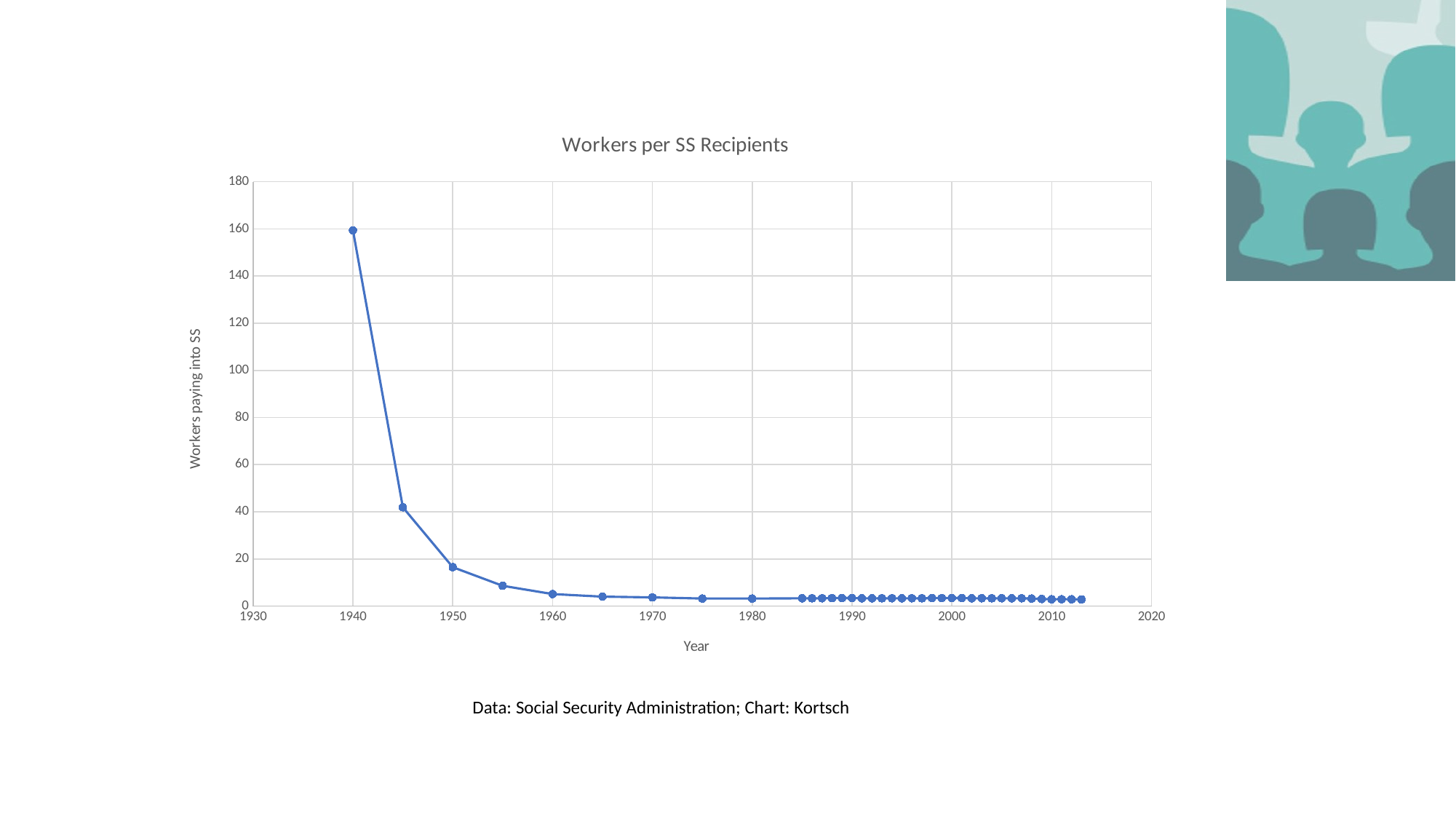
What kind of chart is shown on the slide? line chart What is the label on the vertical axis of the chart? Workers paying into SS Do the values rise or fall as the year increases along the x axis? fall Is the value for 1940 greater or less than 140? greater What is the title of the chart? Workers per SS Recipients Is the value for 1945 greater or less than 20? greater Which has the larger value, 1940 or 1950? 1940 Which has the larger value, 1945 or 1960? 1945 Which year has the highest value for workers per SS recipient? 1940 Is the value for 2010 greater or less than 20? less